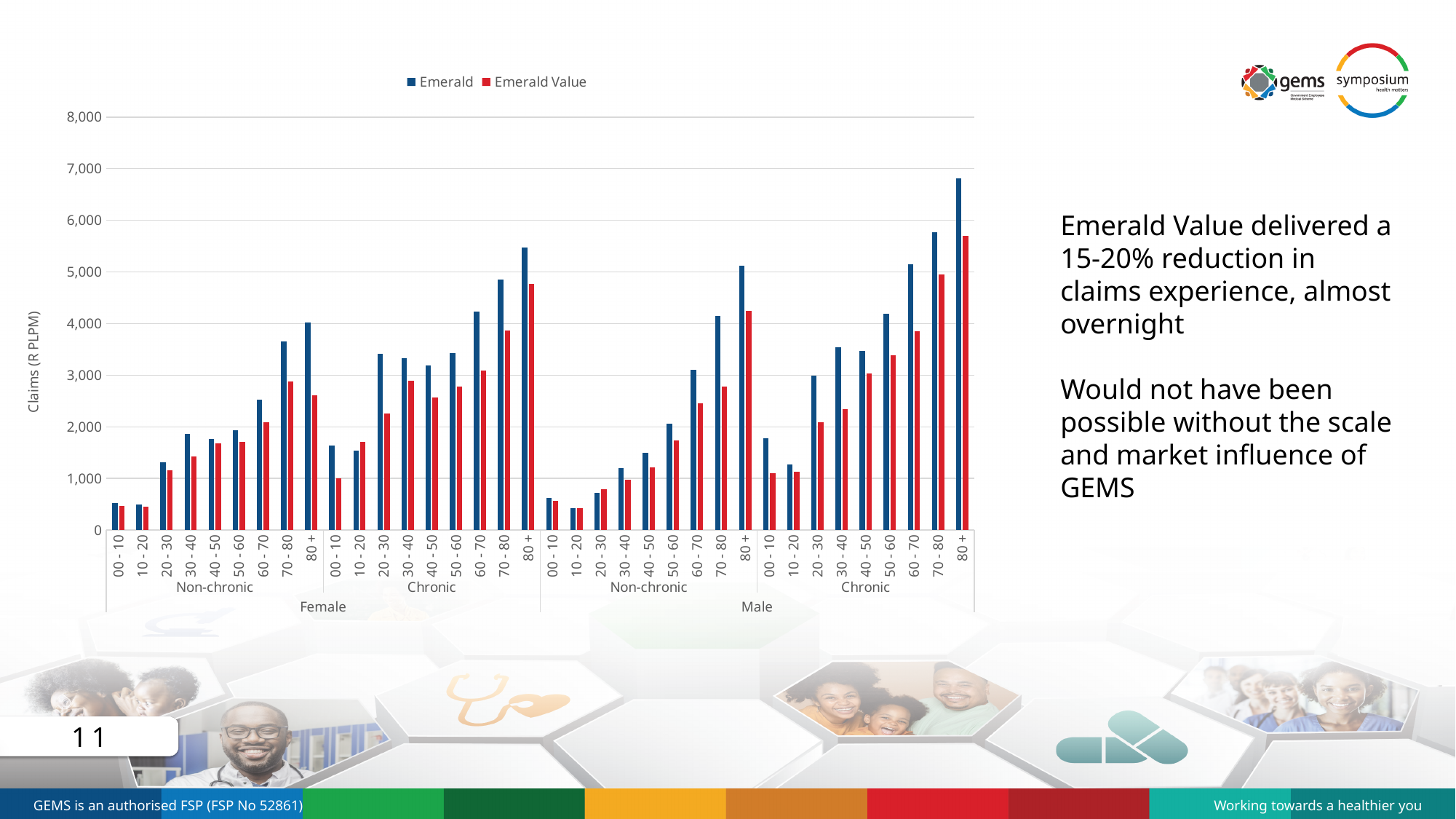
How many age bands are shown within each Non-chronic or Chronic group? 9 Within the Male Chronic group, do the Emerald bars generally rise or fall from the 20 - 30 band to the 80 + band? rise Is the Emerald Value bar for the Female Chronic 80 + group greater or less than 5,000? less How many series does the legend list? 2 Is the Emerald value for the Male Chronic 80 + group greater or less than 6,000? greater Is the Emerald value for the Female Chronic 80 + group greater or less than 5,000? greater What is the label on the vertical axis of the chart? Claims (R PLPM) Which is larger: the Emerald bar for Male Chronic 80 + or the Emerald bar for Female Chronic 80 +? Male Chronic 80 + For the Female Chronic 10 - 20 group, which series has the taller bar, Emerald or Emerald Value? Emerald Value What kind of chart is shown on the slide? Bar chart Which group and age band has the highest Emerald bar on the chart? Male, Chronic, 80 +